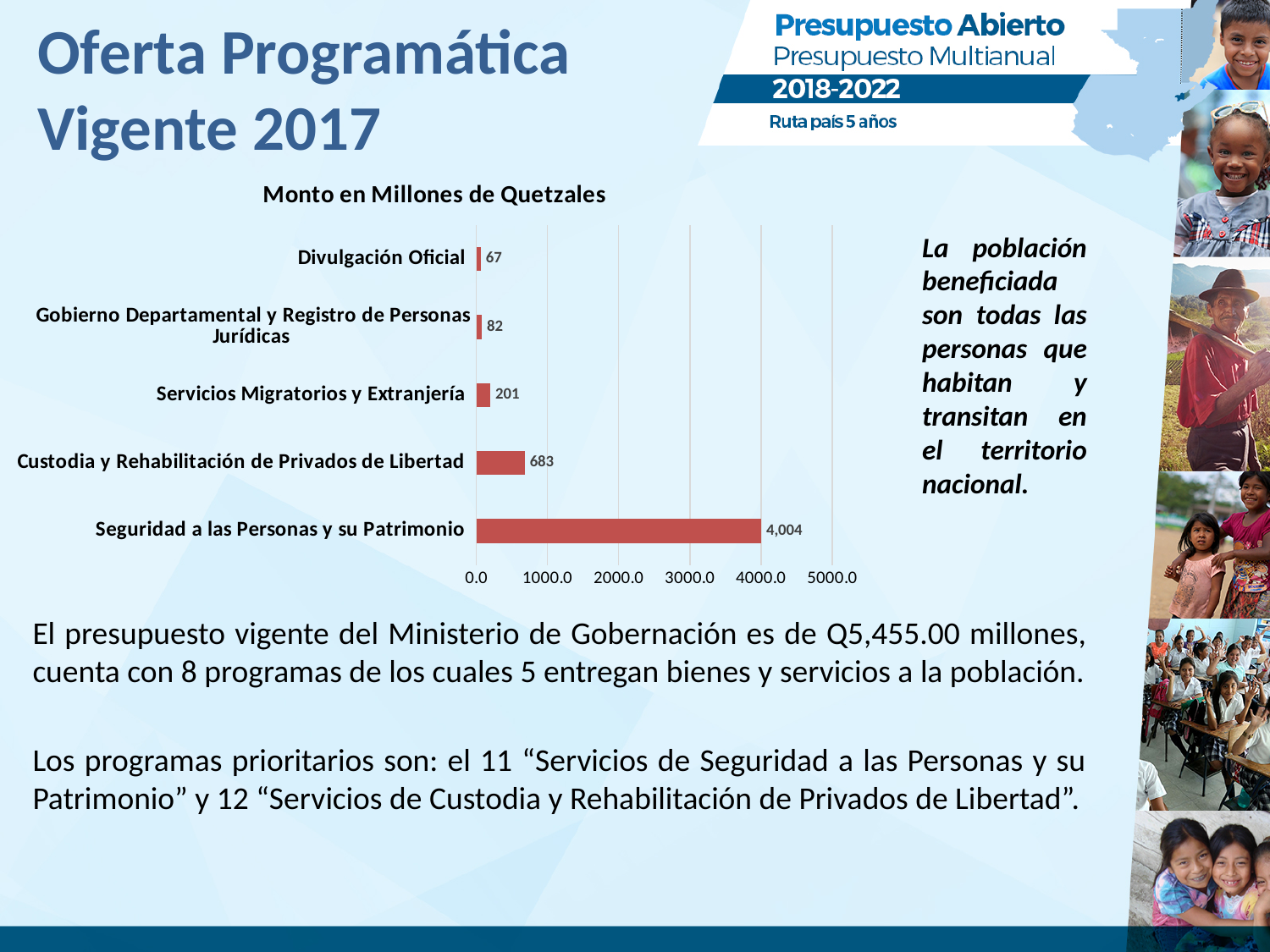
How many categories are shown in the chart? 5 What is the value for Custodia y Rehabilitación de Privados de Libertad? 683 What is the value for Divulgación Oficial? 67 Is the value for Custodia y Rehabilitación de Privados de Libertad greater or less than 1000.0? less Which category has the highest value? Seguridad a las Personas y su Patrimonio What kind of chart is shown? bar chart What is the value for Seguridad a las Personas y su Patrimonio? 4,004 What is the title of the chart? Monto en Millones de Quetzales Which category has the lowest value? Divulgación Oficial What is the difference between Seguridad a las Personas y su Patrimonio and Custodia y Rehabilitación de Privados de Libertad? 3,321 Which is larger: Servicios Migratorios y Extranjería or Gobierno Departamental y Registro de Personas Jurídicas? Servicios Migratorios y Extranjería What is the value for Servicios Migratorios y Extranjería? 201